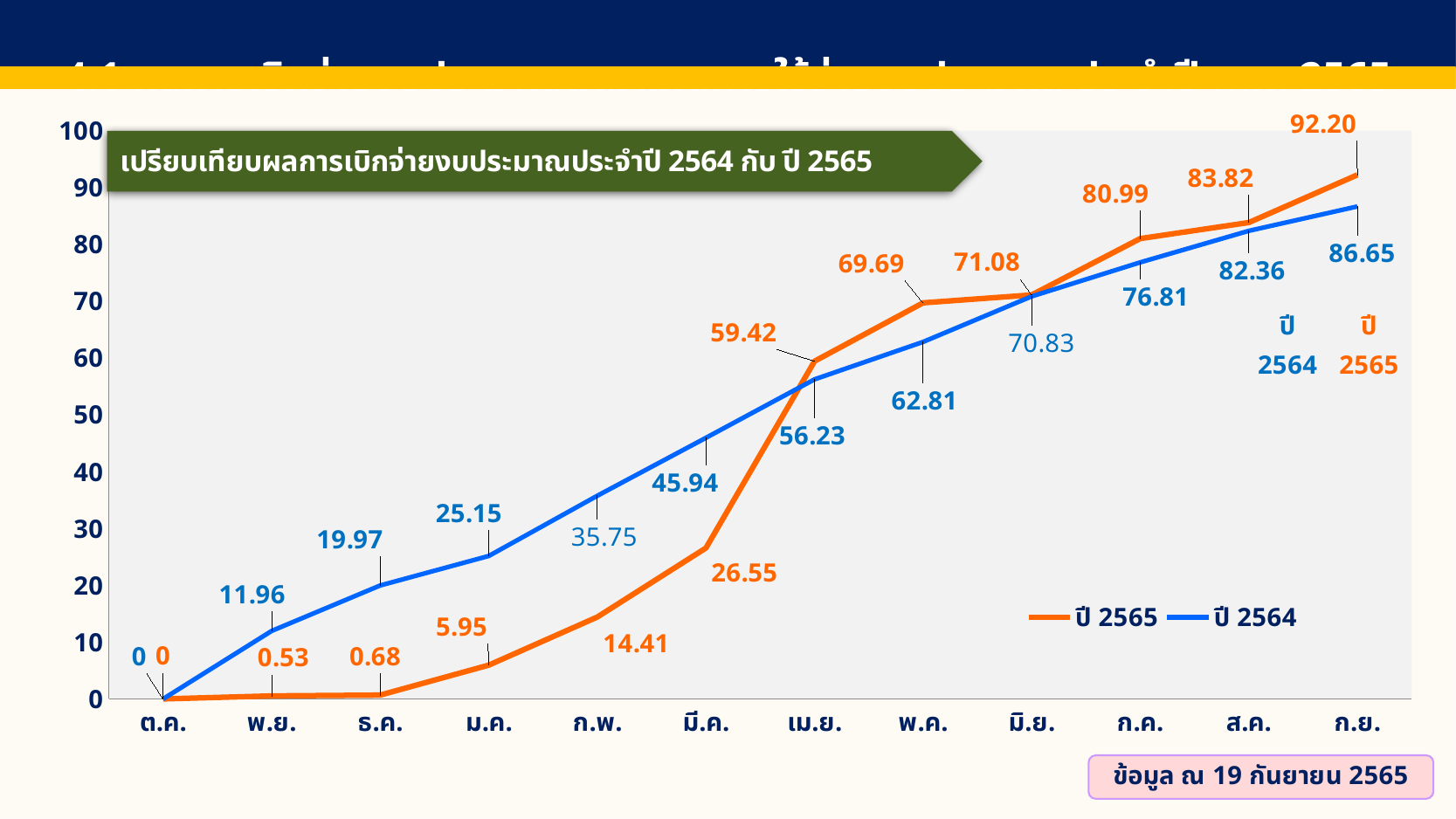
What is the difference between ปี 2565 and ปี 2564 in ก.ย.? 5.55 Which series has the larger value in ม.ค., ปี 2564 or ปี 2565? ปี 2564 How many series does the legend list? 2 Which colour represents the ปี 2565 series in the legend? orange What is the value for ปี 2564 in ก.พ.? 35.75 What is the value for ปี 2565 in ก.ย.? 92.20 What is the value for ปี 2565 in มี.ค.? 26.55 In which month is the ปี 2564 series highest? ก.ย. What type of chart is shown on the slide? line chart What is the value for ปี 2564 in มิ.ย.? 70.83 How many months are shown on the x axis? 12 Do the values for ปี 2565 rise or fall from ต.ค. to ก.ย.? rise